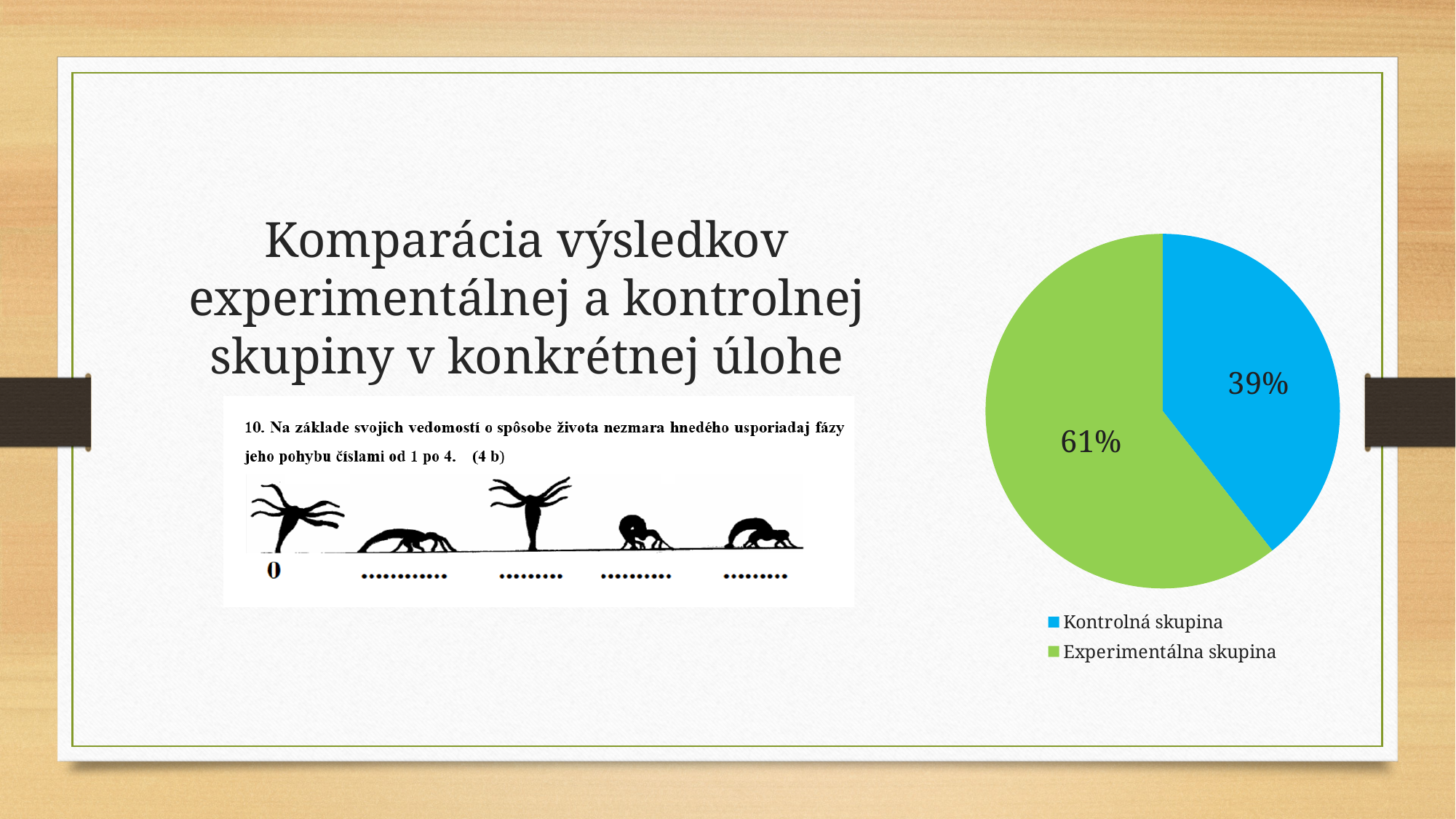
What colour is the slice for Experimentálna skupina? green What colour is the slice for Kontrolná skupina? blue What kind of chart is shown on the slide? pie chart What is the difference between the values for Experimentálna skupina and Kontrolná skupina? 22% What is the value for Kontrolná skupina? 39% What is the value for Experimentálna skupina? 61% Which is larger, the value for Kontrolná skupina or the value for Experimentálna skupina? Experimentálna skupina Which group has the smallest slice of the pie? Kontrolná skupina How many entries does the legend list? 2 How many slices does the pie chart have? 2 What share of the pie does Experimentálna skupina take? 61% Which group has the largest slice of the pie? Experimentálna skupina